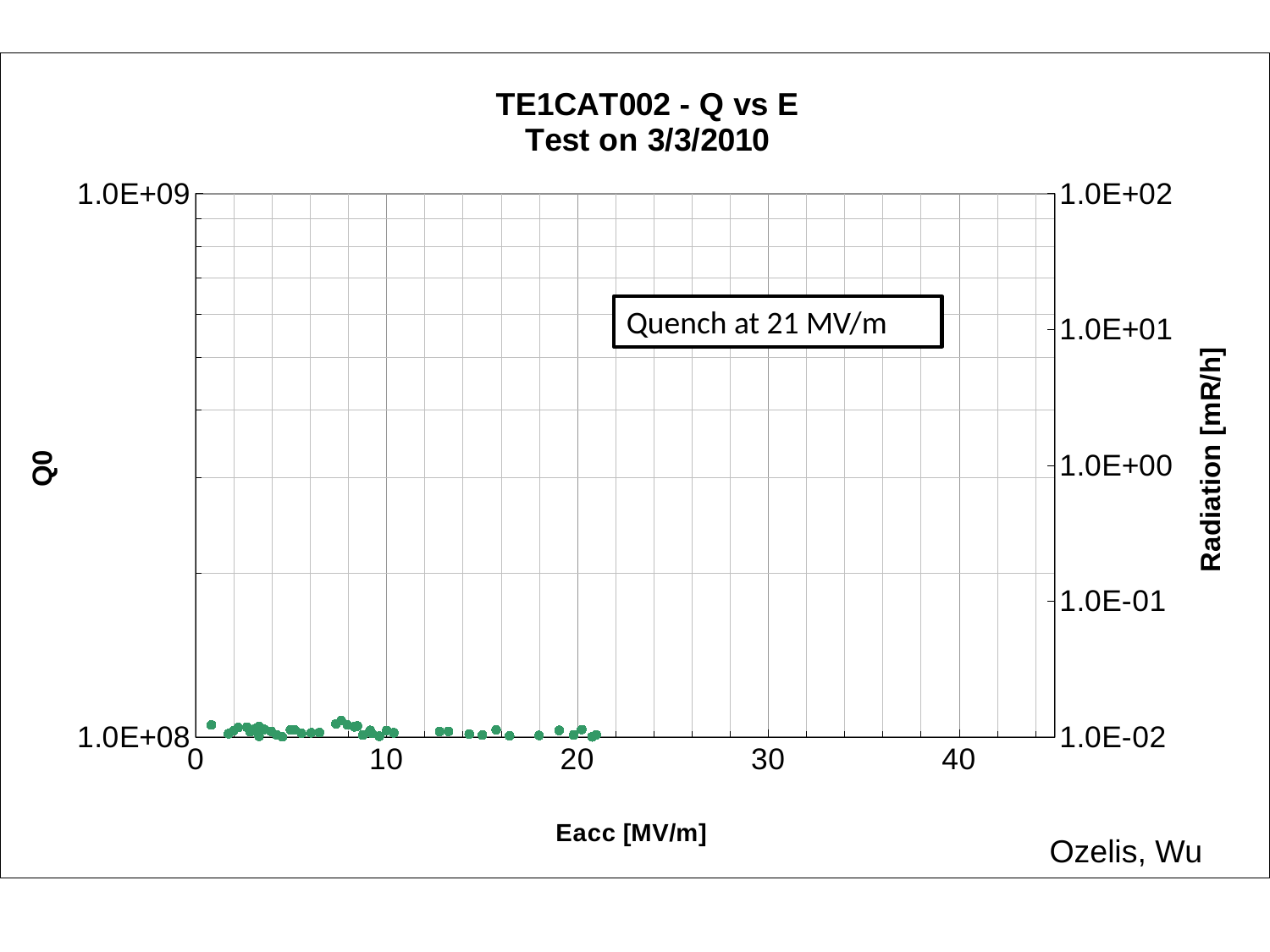
What is the lowest tick value shown on the left Q0 axis? 1.0E+08 What kind of chart is shown on the slide? scatter chart Are the Eacc values of the plotted points greater or less than 30 MV/m? less What is the highest tick label shown on the x axis? 40 What is the highest tick value shown on the right Radiation axis? 1.0E+02 What is the label of the x axis? Eacc [MV/m] According to the annotation on the chart, at what Eacc did the quench occur? 21 MV/m What is the title of the chart? TE1CAT002 - Q vs E Test on 3/3/2010